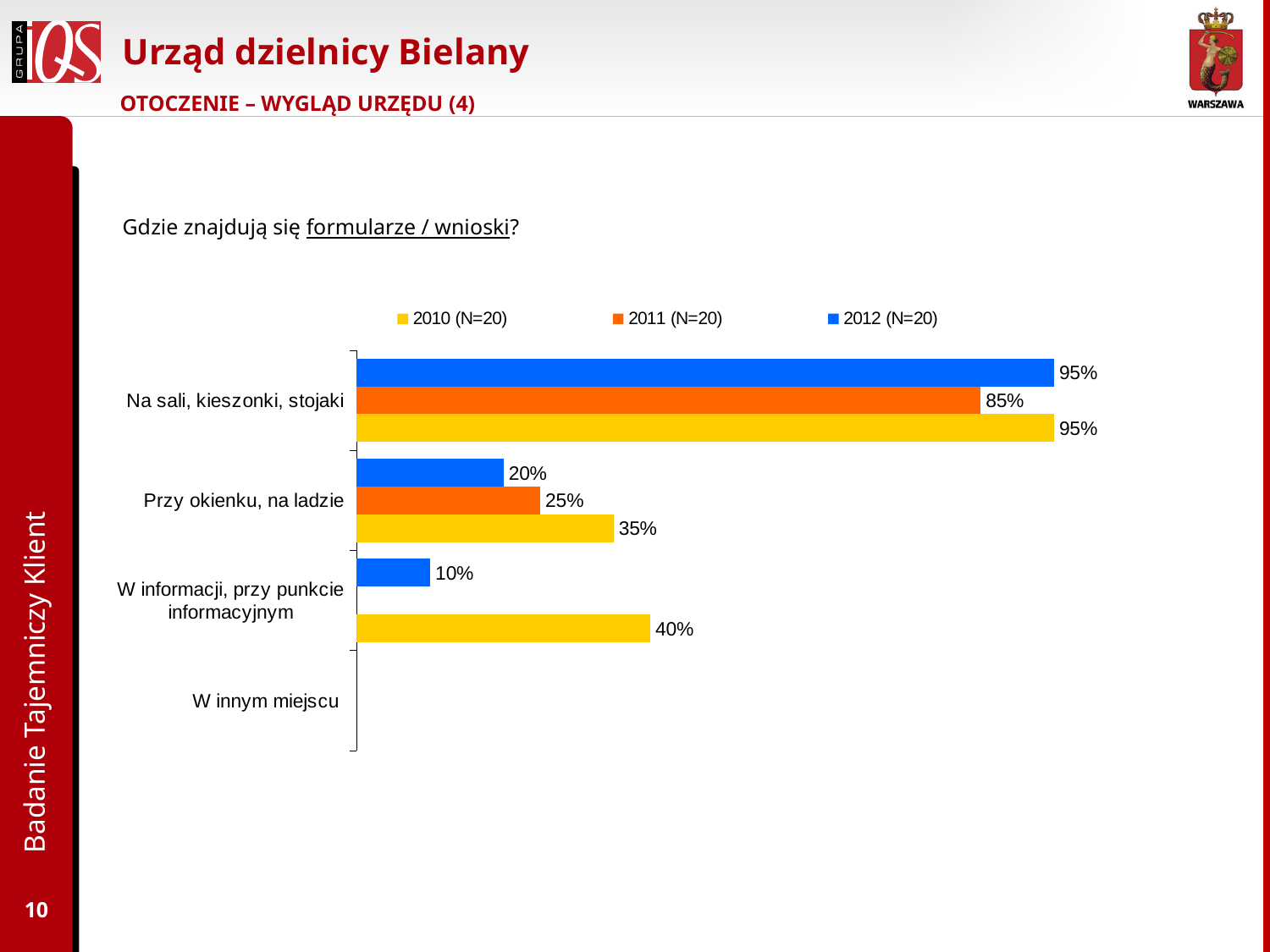
How many categories are shown on the chart? 4 Which colour represents the 2011 (N=20) series? Orange How many series does the legend list? 3 What kind of chart is shown on the slide? Bar chart What is the value for 'Na sali, kieszonki, stojaki' in the 2012 (N=20) series? 95% Which is larger for 'Przy okienku, na ladzie': the 2011 value or the 2012 value? 2011 (N=20) What is the value for 'W informacji, przy punkcie informacyjnym' in the 2012 (N=20) series? 10% What is the difference between the 2010 and 2011 values for 'Przy okienku, na ladzie'? 10% Which category has the highest value in the 2010 (N=20) series? Na sali, kieszonki, stojaki What is the value for 'Na sali, kieszonki, stojaki' in the 2011 (N=20) series? 85% What is the difference between the 2010 and 2012 values for 'W informacji, przy punkcie informacyjnym'? 30% What is the value for 'Przy okienku, na ladzie' in the 2010 (N=20) series? 35%